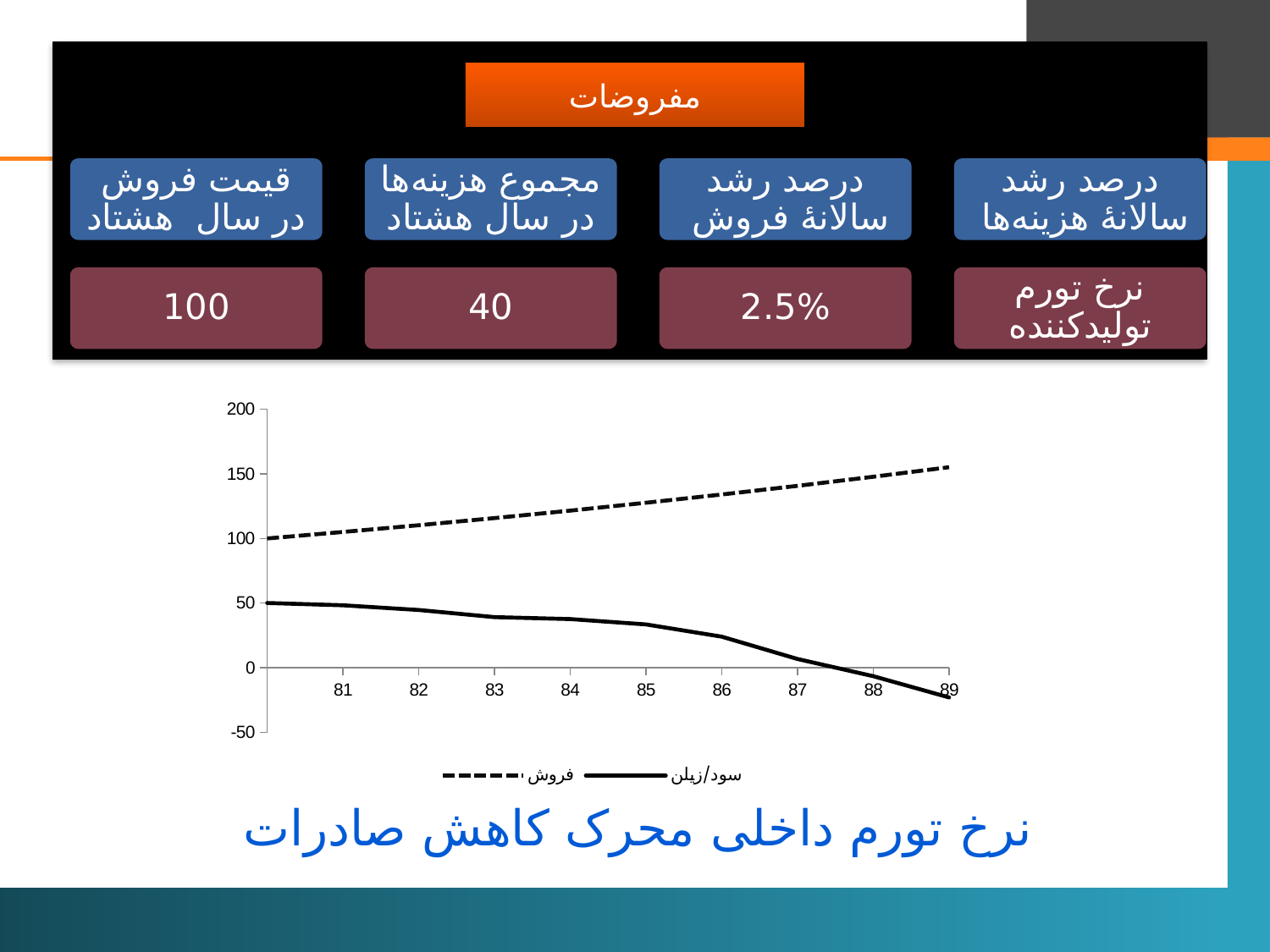
Does the فروش line rise or fall from 81 to 89? rises What kind of chart is shown on the slide? line chart How many year labels are shown on the x axis of the chart? 9 How many series does the chart legend list? 2 Is the value of سود/زیان at 83 greater or less than 50? less Is the value of سود/زیان at 86 greater or less than 0? greater Which series is drawn with a dashed line? فروش At 89, which series has the larger value, فروش or سود/زیان? فروش Is the value of فروش at 85 greater or less than 100? greater In which year does the سود/زیان series reach its lowest value? 89 Does the سود/زیان line rise or fall from 81 to 89? falls